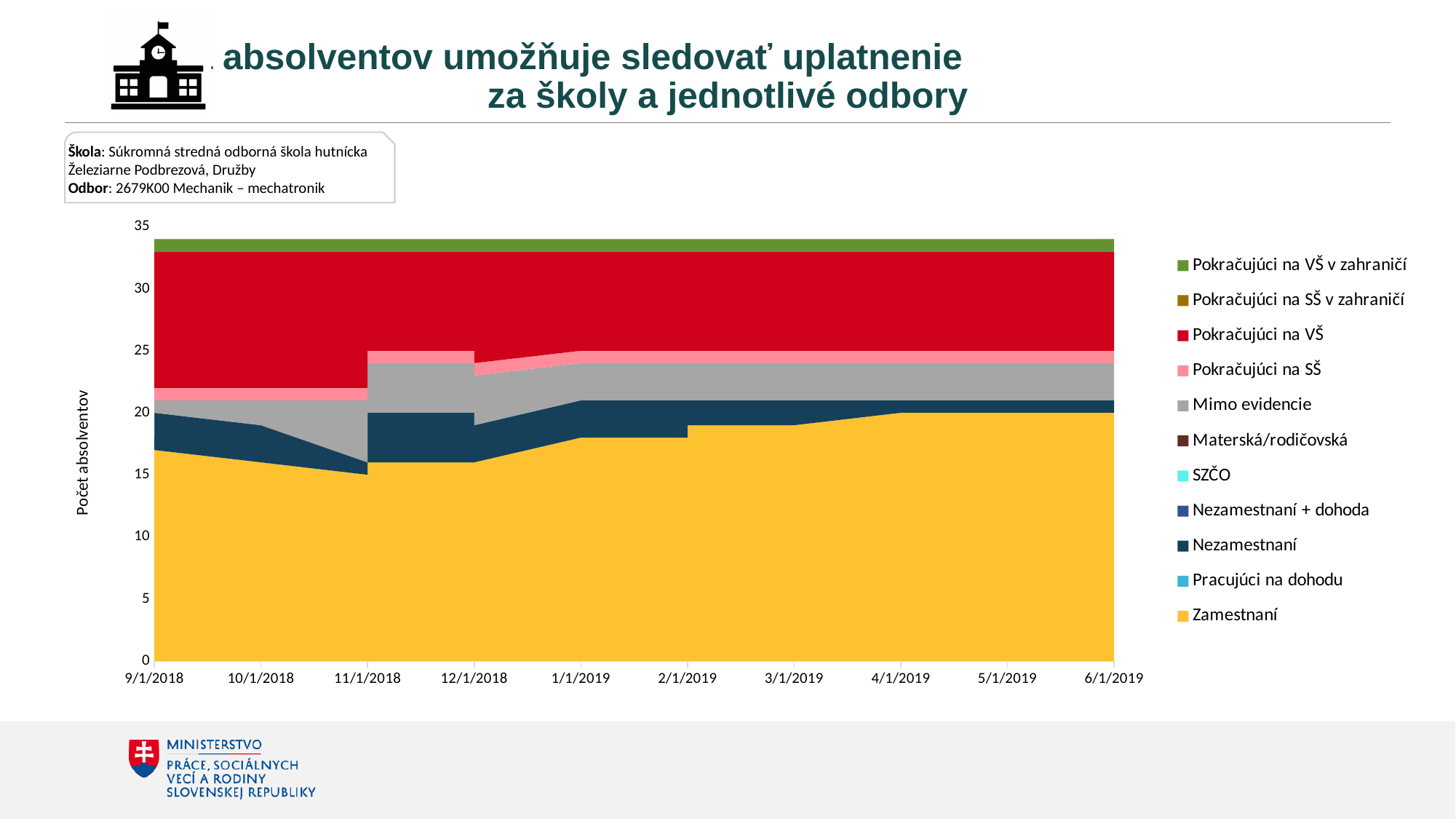
Is the value for Zamestnaní at 12/1/2018 greater or less than 10? greater Is the total stacked value at 6/1/2019 greater or less than 35? less Is the value for Zamestnaní at 9/1/2018 greater or less than 15? greater What is the label of the y axis? Počet absolventov Which series occupies the largest area in the chart? Zamestnaní How many dates are shown on the x axis? 10 What kind of chart is shown on the slide? Stacked area chart Which series is listed last in the legend? Zamestnaní Is the value for Zamestnaní at 6/1/2019 larger than at 11/1/2018? Yes Does the value for Zamestnaní rise or fall from 11/1/2018 to 6/1/2019? rise How many series does the legend list? 11